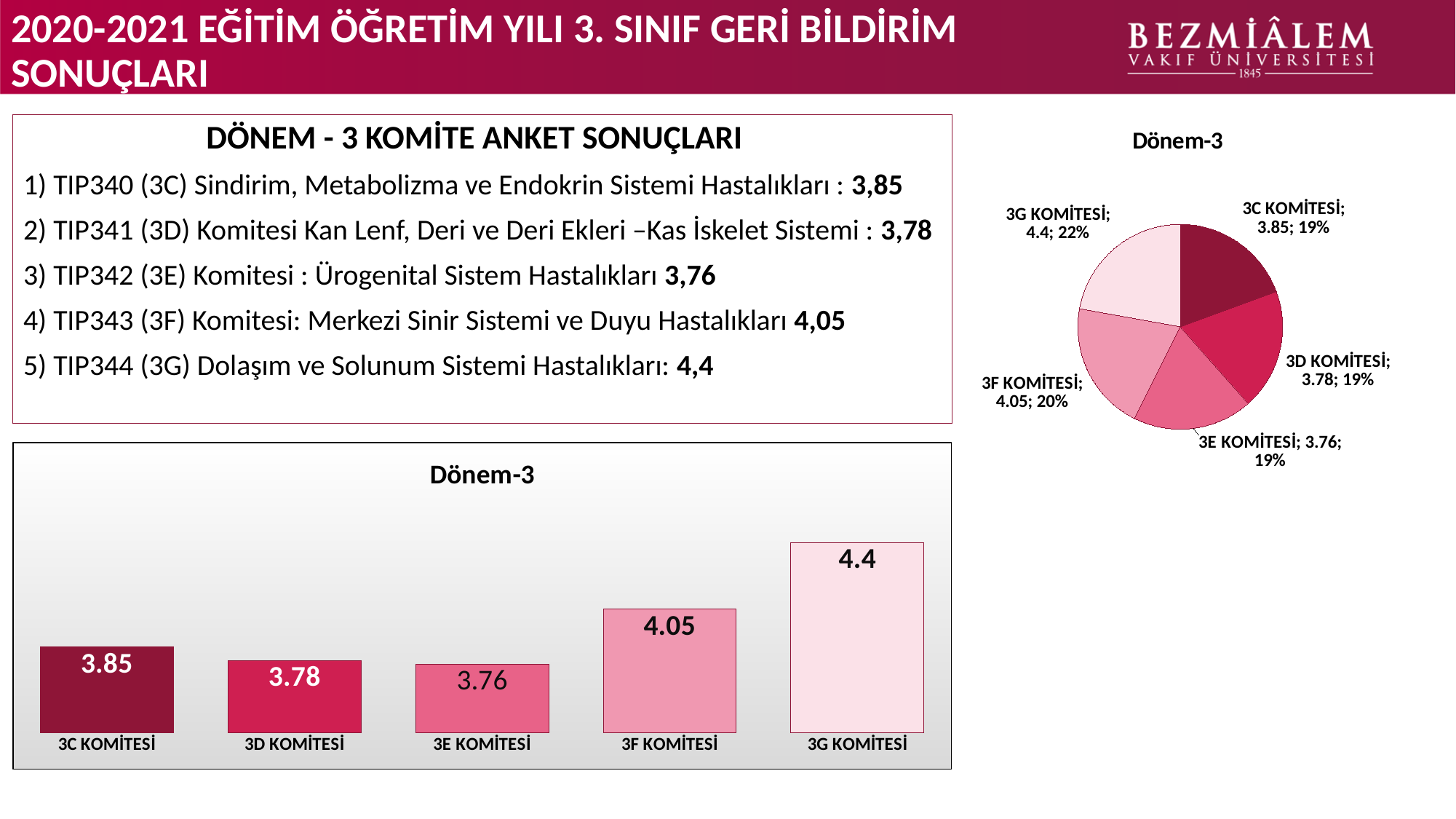
In the bar chart at the bottom of the slide, what is the value for 3F KOMİTESİ? 4.05 What is the title of the pie chart on the right of the slide? Dönem-3 In the pie chart on the right of the slide, what share does 3G KOMİTESİ have? 22% What kind of chart is the chart on the right of the slide? pie chart In the bar chart at the bottom of the slide, which category has the highest value? 3G KOMİTESİ In the bar chart at the bottom of the slide, what is the difference between the values for 3G KOMİTESİ and 3C KOMİTESİ? 0.55 In the bar chart at the bottom of the slide, which category has the lowest value? 3E KOMİTESİ In the pie chart on the right of the slide, what share does 3F KOMİTESİ have? 20% In the bar chart at the bottom of the slide, which is larger, the value for 3C KOMİTESİ or the value for 3D KOMİTESİ? 3C KOMİTESİ How many categories are shown in the bar chart at the bottom of the slide? 5 In the bar chart at the bottom of the slide, what is the value for 3E KOMİTESİ? 3.76 What kind of chart is the chart at the bottom of the slide? bar chart